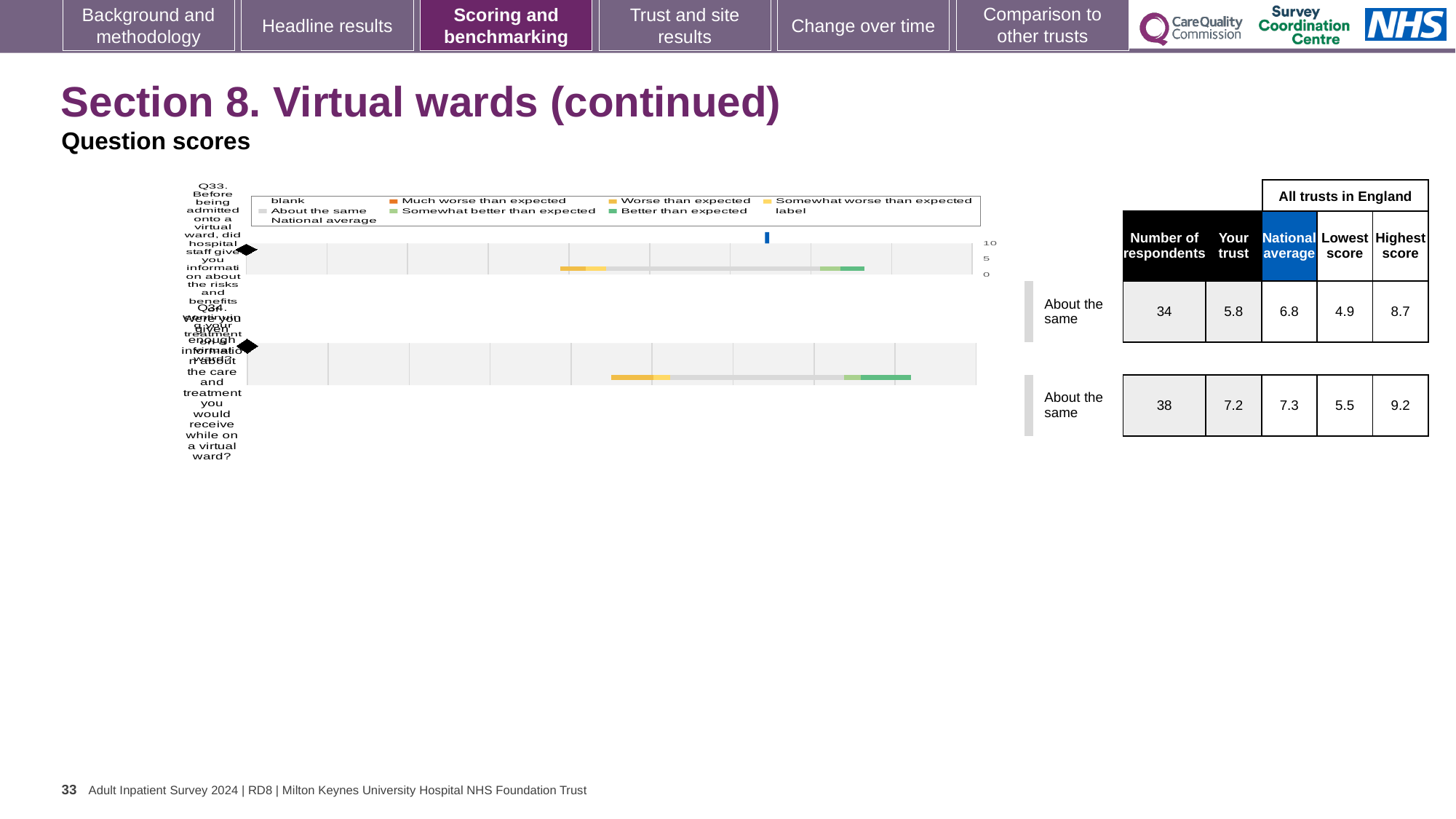
How many respondents answered Q33 according to the table? 34 For Q33, which is larger: the 'Your trust' score or the national average? National average What is the difference between the highest and lowest scores for Q34? 3.7 What is the highest score among all trusts in England for Q34? 9.2 Which question has more respondents, Q33 or Q34? Q34 What kind of chart is shown on the slide? bar chart How many questions (bars) are plotted in the chart? 2 What is the lowest score among all trusts in England for Q33? 4.9 According to the legend, what does the blue marker on the chart represent? National average What benchmark category is shown for Q34? About the same What is the 'Your trust' score for Q33 shown in the table next to the chart? 5.8 What is the national average score for Q34 shown in the table next to the chart? 7.3